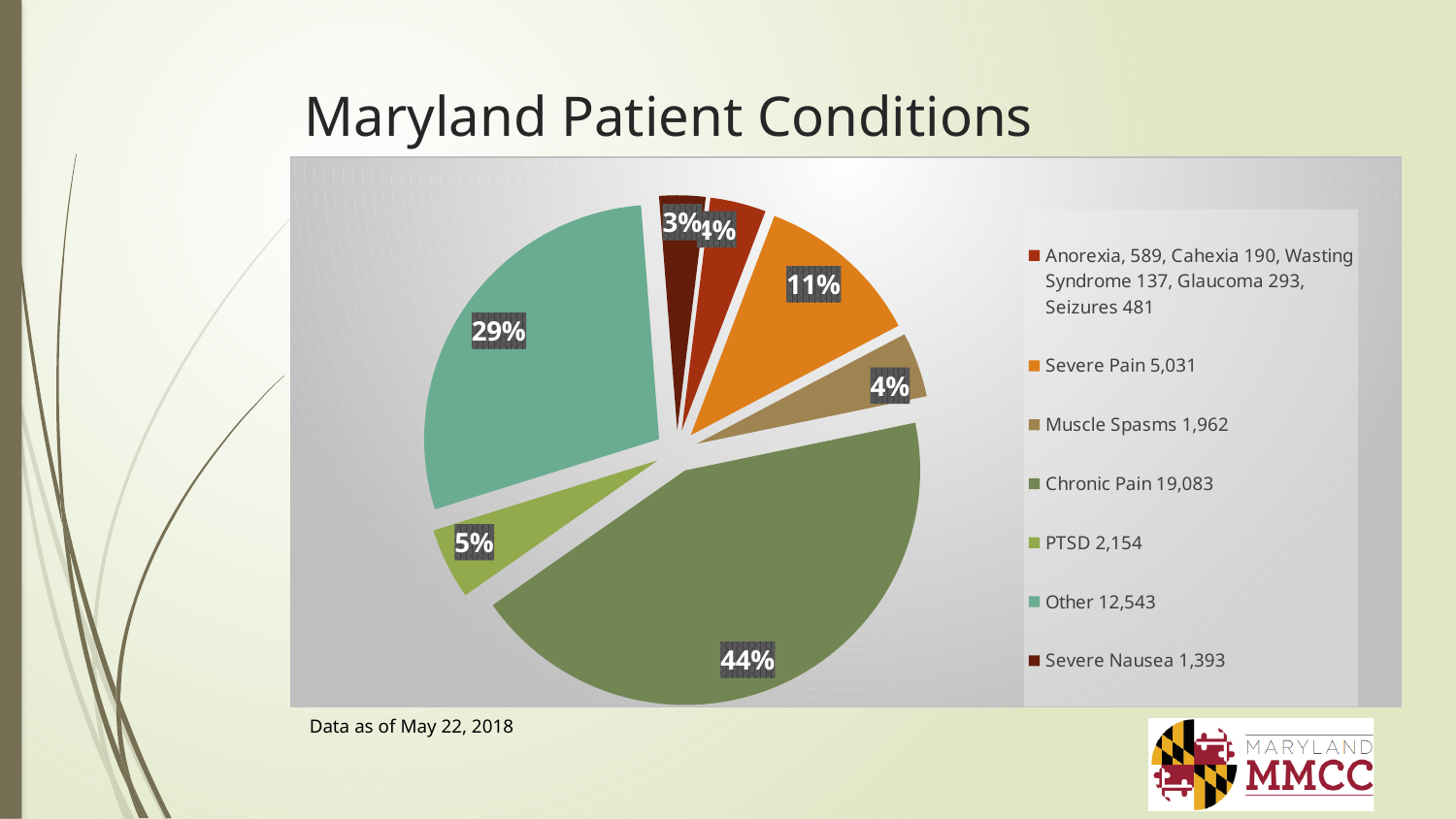
What percentage of the pie does PTSD represent? 5% Which condition has the largest slice of the pie? Chronic Pain What percentage of the pie does Muscle Spasms represent? 4% What patient count is shown in the legend for Chronic Pain? 19,083 What type of chart is shown on the slide? pie chart What is the difference in percentage points between the Chronic Pain slice and the Other slice? 15 What percentage of the pie does the Other category represent? 29% How many categories does the legend list? 7 What is the title of the slide containing the chart? Maryland Patient Conditions Which slice is larger, Other or Severe Pain? Other